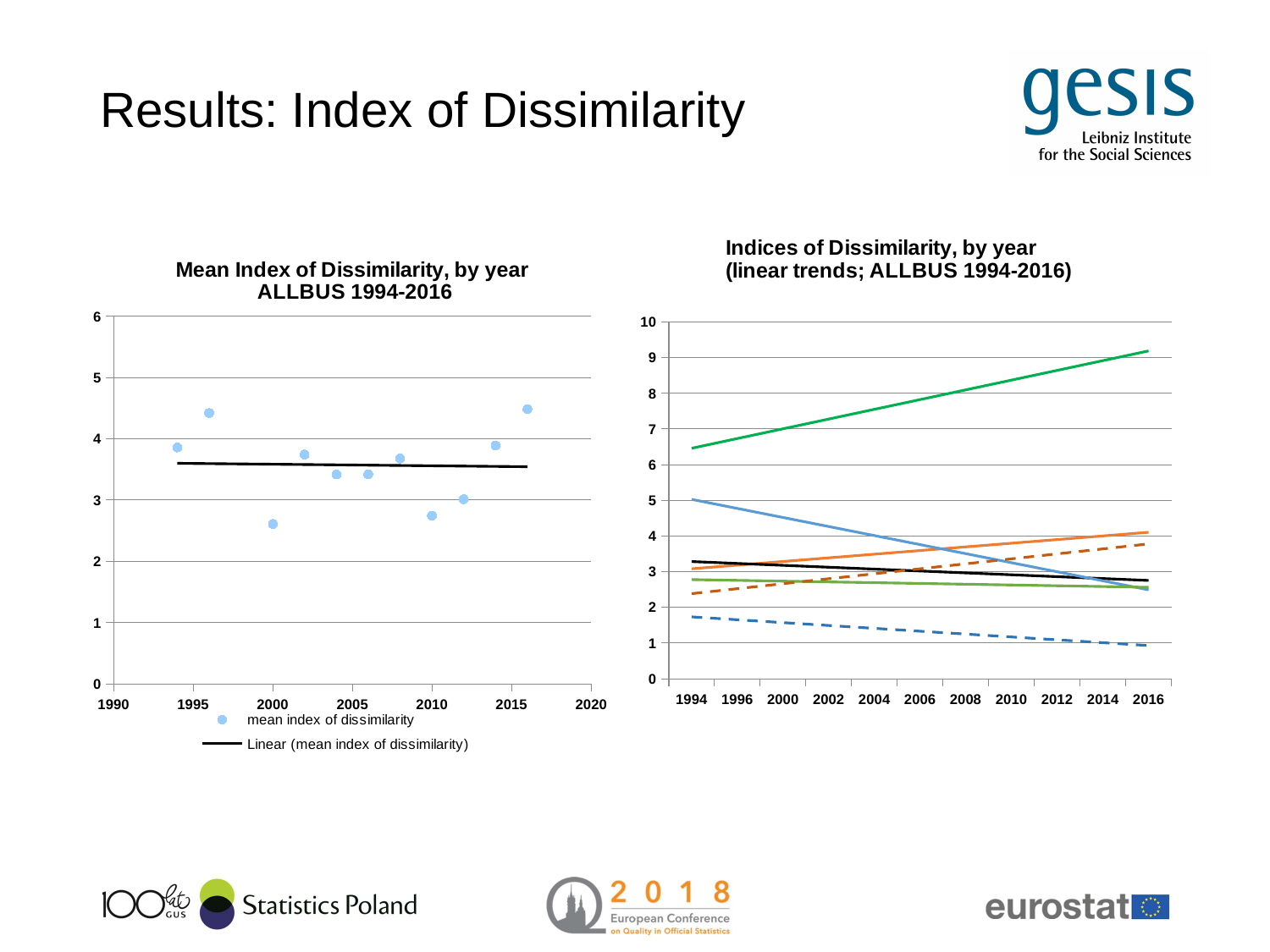
In the left chart 'Mean Index of Dissimilarity, by year', does the linear trend line rise or fall from 1994 to 2016? falls How many years are labelled on the x axis of the right chart 'Indices of Dissimilarity, by year'? 11 What kind of chart is the right chart, 'Indices of Dissimilarity, by year (linear trends; ALLBUS 1994-2016)'? line chart How many entries does the legend of the left chart 'Mean Index of Dissimilarity, by year' list? 2 In the left chart 'Mean Index of Dissimilarity, by year', is the value for 1996 greater or less than 4? greater In the left chart 'Mean Index of Dissimilarity, by year', is the value for 2000 larger or smaller than the value for 1996? smaller In the left chart 'Mean Index of Dissimilarity, by year', how many data points are plotted? 11 In the left chart 'Mean Index of Dissimilarity, by year', is the value for 2016 greater or less than 4? greater What is the full title of the right chart? Indices of Dissimilarity, by year (linear trends; ALLBUS 1994-2016) What kind of chart is the left chart, 'Mean Index of Dissimilarity, by year ALLBUS 1994-2016'? scatter chart In the left chart 'Mean Index of Dissimilarity, by year', is the value for 2010 greater or less than 3? less